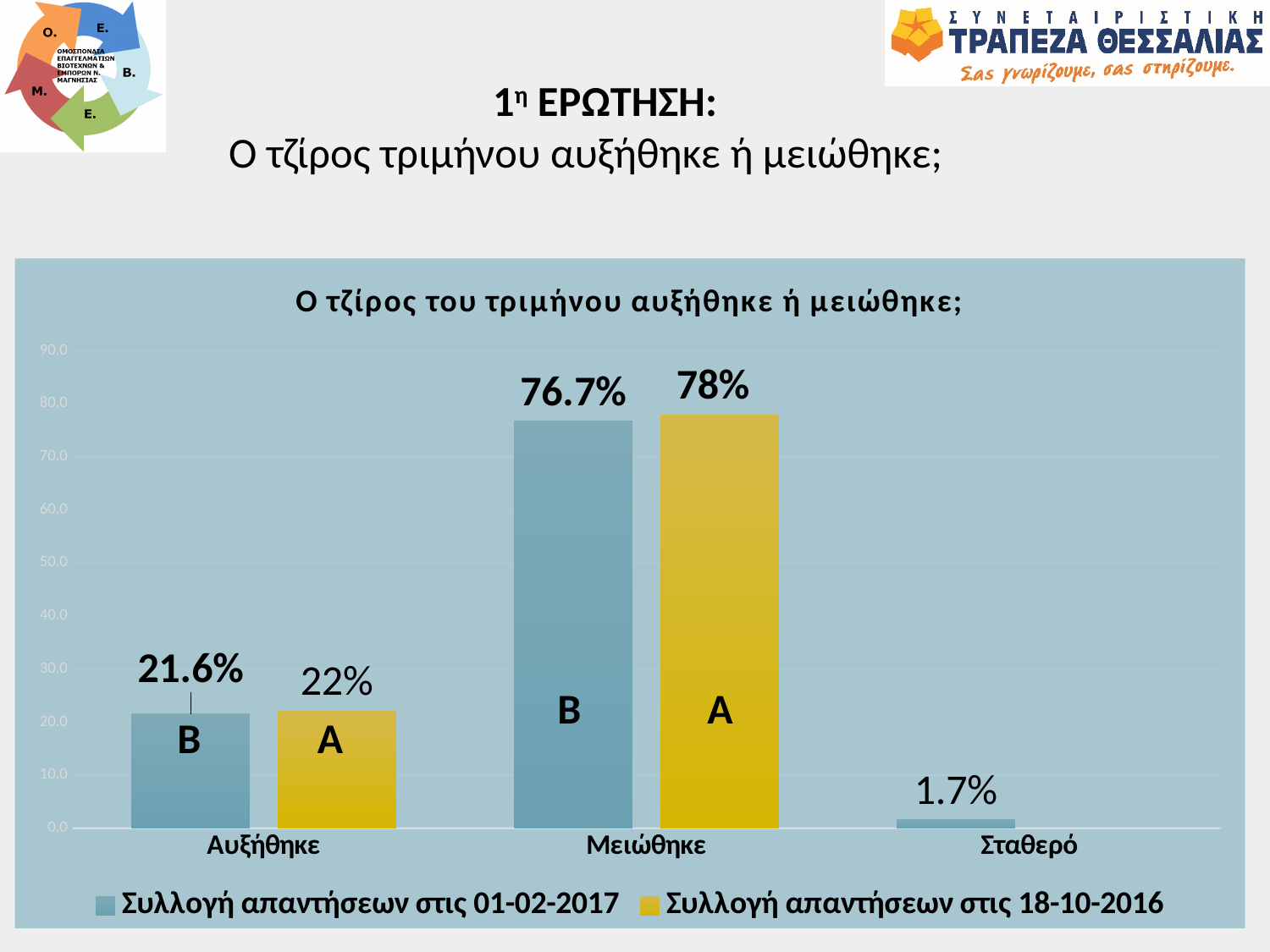
What is the value for Αυξήθηκε in the series Συλλογή απαντήσεων στις 01-02-2017? 21.6% What is the difference between the Μειώθηκε and Αυξήθηκε values in the series Συλλογή απαντήσεων στις 18-10-2016? 56% What is the value for Μειώθηκε in the series Συλλογή απαντήσεων στις 01-02-2017? 76.7% Which category has the lowest value in the series Συλλογή απαντήσεων στις 01-02-2017? Σταθερό What is the value for Μειώθηκε in the series Συλλογή απαντήσεων στις 18-10-2016? 78% What type of chart is shown on the slide? bar chart What is the value for Σταθερό in the series Συλλογή απαντήσεων στις 01-02-2017? 1.7% What is the value for Αυξήθηκε in the series Συλλογή απαντήσεων στις 18-10-2016? 22% How many series does the legend list? 2 Which is larger for Μειώθηκε: the value for Συλλογή απαντήσεων στις 01-02-2017 or for Συλλογή απαντήσεων στις 18-10-2016? Συλλογή απαντήσεων στις 18-10-2016 Which category has the highest value in the series Συλλογή απαντήσεων στις 01-02-2017? Μειώθηκε How many categories are shown on the x axis? 3